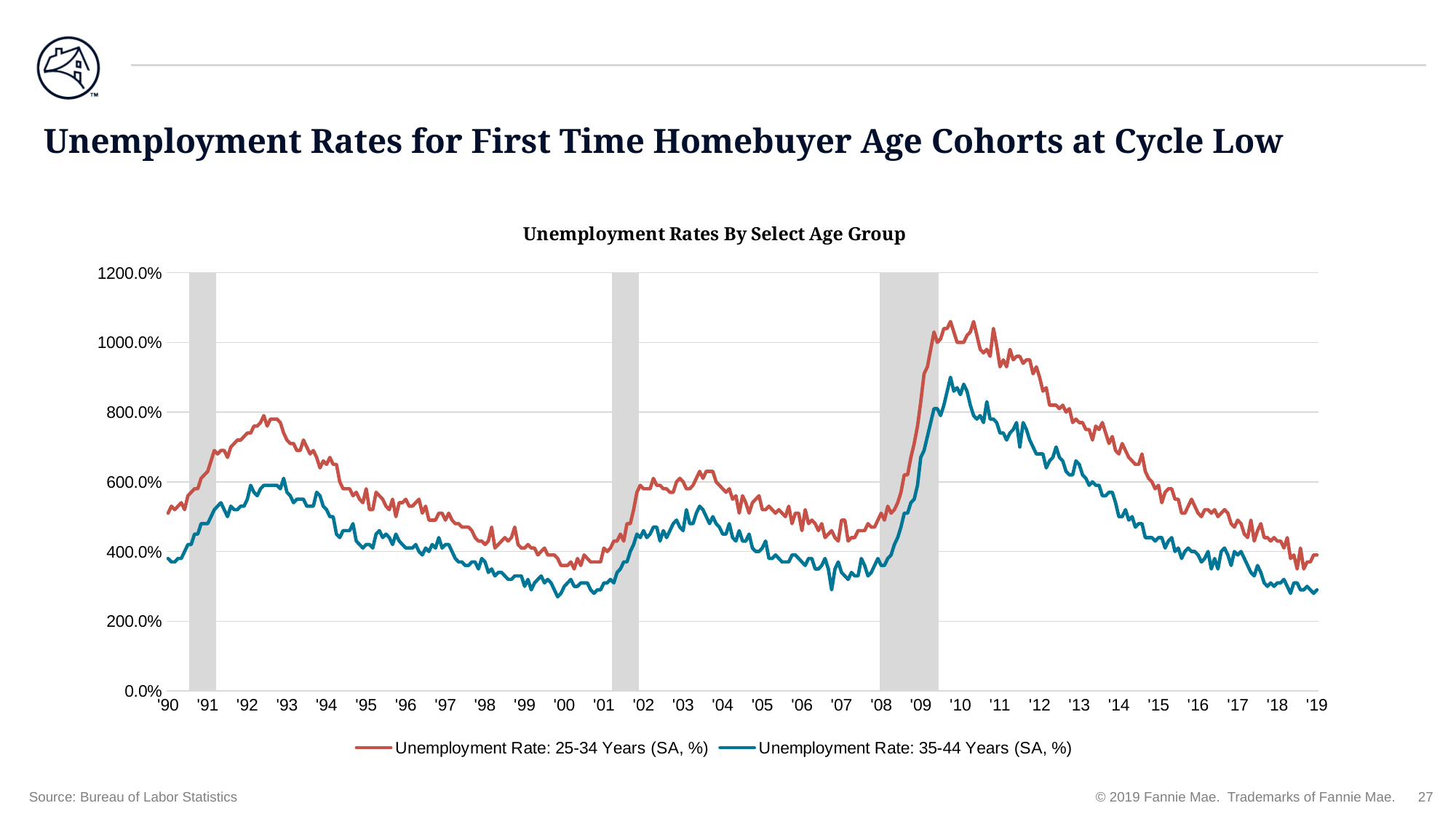
Which series is drawn in red? Unemployment Rate: 25-34 Years (SA, %) Which series is higher across the whole period, the 25-34 Years series or the 35-44 Years series? Unemployment Rate: 25-34 Years (SA, %) What kind of chart is shown on the slide? line chart Is the value of the 35-44 Years series at '00 greater or less than 400.0%? less How many series does the legend list? 2 Is the peak value of the 25-34 Years series around '10 greater or less than 1000.0%? greater What is the title of the chart? Unemployment Rates By Select Age Group Is the value of the 25-34 Years series at '93 greater or less than 600.0%? greater How many year labels are shown on the x axis? 30 Do the unemployment rates rise or fall from '10 to '19? fall